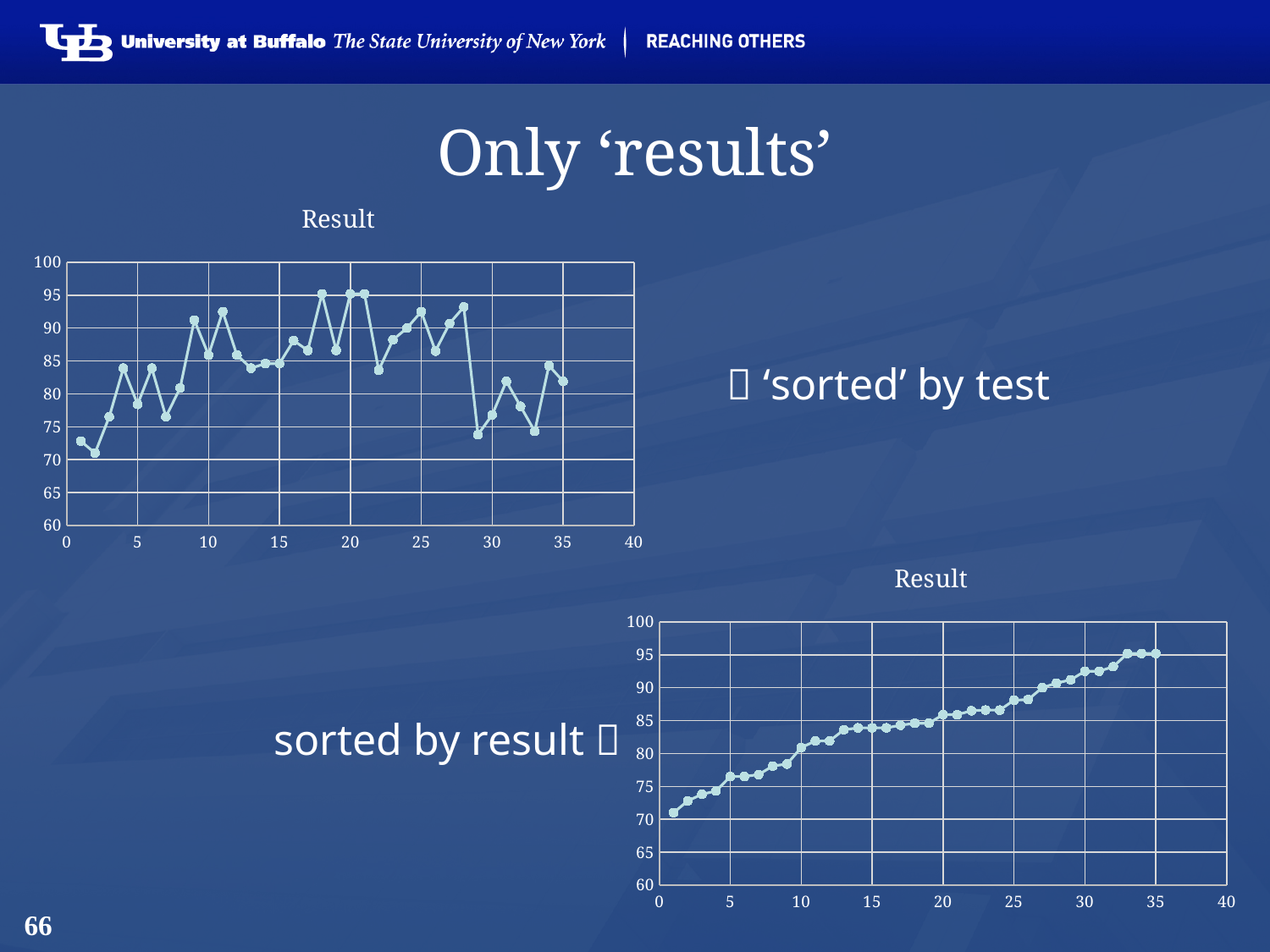
In the top-left chart (sorted by test), which has the larger value: x = 9 or x = 2? x = 9 What title is shown above each of the two charts on the slide? Result What is the highest value shown on the y axis of the top-left chart? 100 In the top-left chart (sorted by test), is the value at x = 18 greater or less than 90? greater In the bottom-right chart (sorted by result), is the value at x = 1 greater or less than 75? less How many data points are plotted in the bottom-right chart (sorted by result)? 35 In the top-left chart (sorted by test), is the value at x = 20 greater or less than 90? greater In the bottom-right chart (sorted by result), do the values rise or fall along the x axis? rise In the bottom-right chart (sorted by result), which has the larger value: x = 30 or x = 5? x = 30 What kind of chart is the top-left chart titled 'Result'? line chart